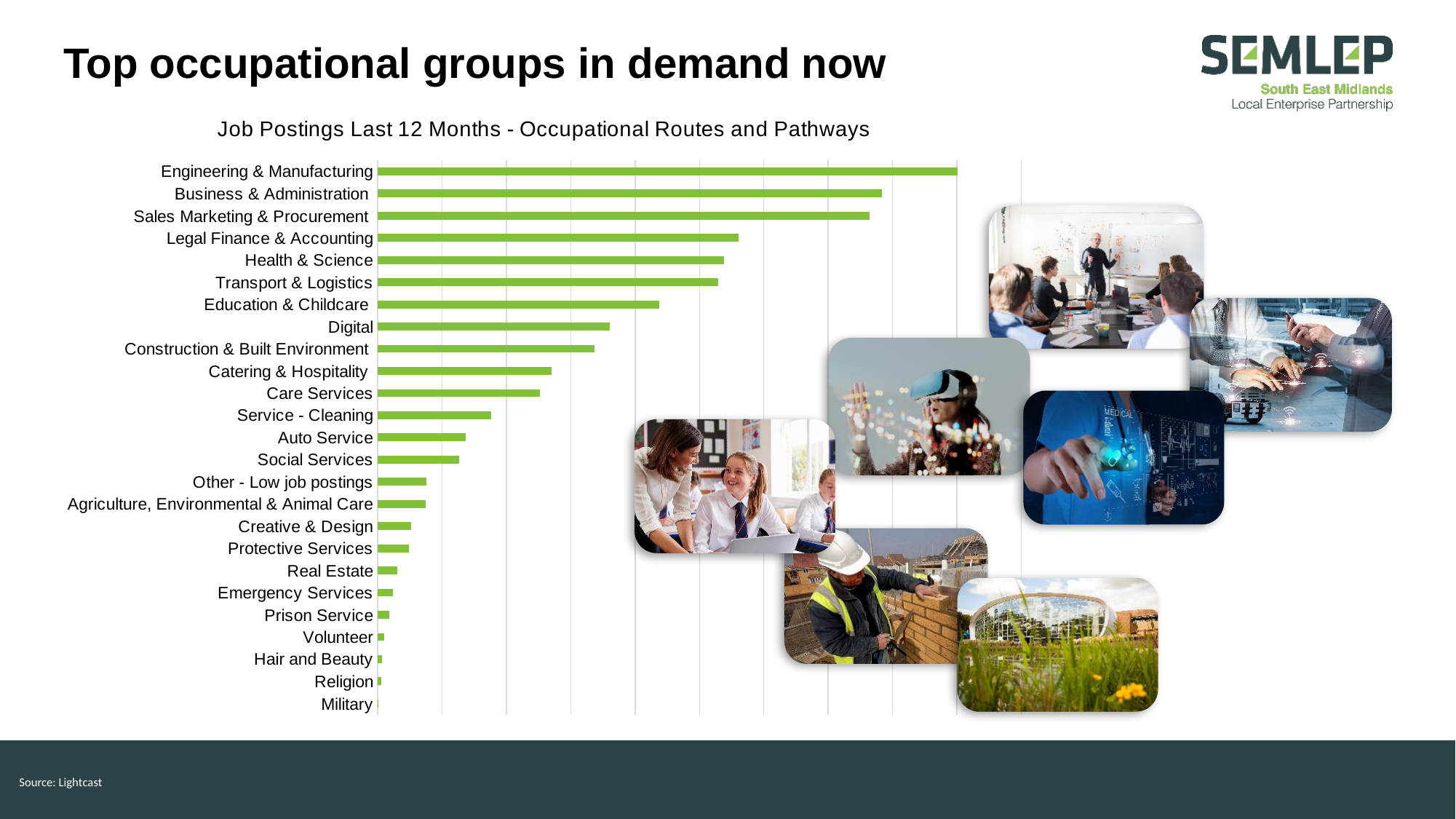
Which has more job postings, Education & Childcare or Digital? Education & Childcare What is the source cited for the chart data? Lightcast What is the title of the chart? Job Postings Last 12 Months - Occupational Routes and Pathways Which has more job postings, Engineering & Manufacturing or Business & Administration? Engineering & Manufacturing How many occupational groups are listed on the chart? 25 Which occupational group has the highest number of job postings? Engineering & Manufacturing Which has more job postings, Health & Science or Catering & Hospitality? Health & Science What kind of chart is shown on the slide? Bar chart Do the bar lengths increase or decrease going down the chart from top to bottom? Decrease Which occupational group has the lowest number of job postings? Military